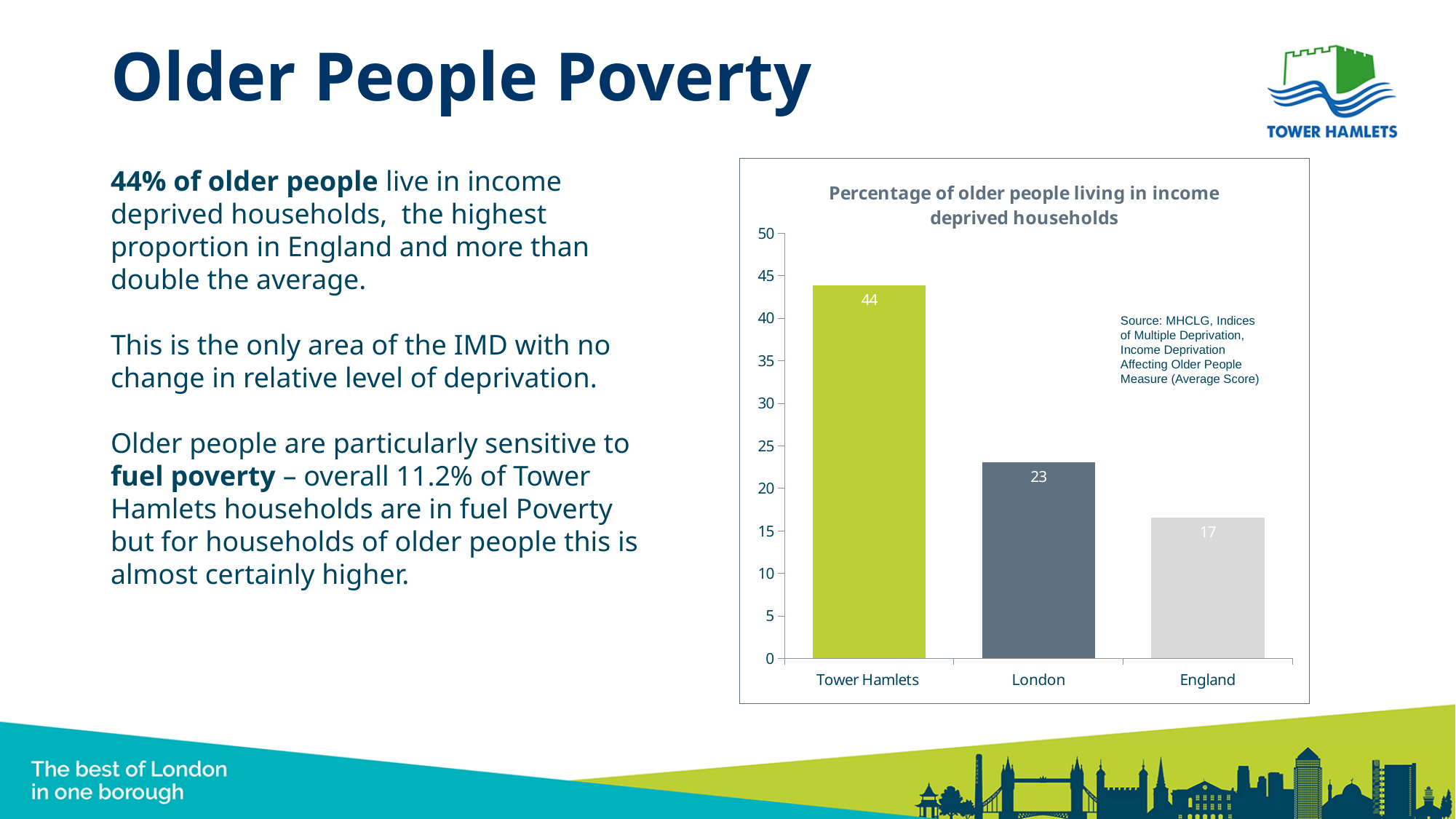
What is the value for London? 23 What is the difference between the values for London and England? 6 Is the value for Tower Hamlets greater or less than 40? greater What is the title of the chart? Percentage of older people living in income deprived households What is the value for England? 17 Which category has the lowest value? England Which is larger, the value for London or the value for England? London What is the difference between the values for Tower Hamlets and London? 21 What is the value for Tower Hamlets? 44 Which category has the highest value? Tower Hamlets How many categories are shown on the chart? 3 What kind of chart is shown on the slide? bar chart